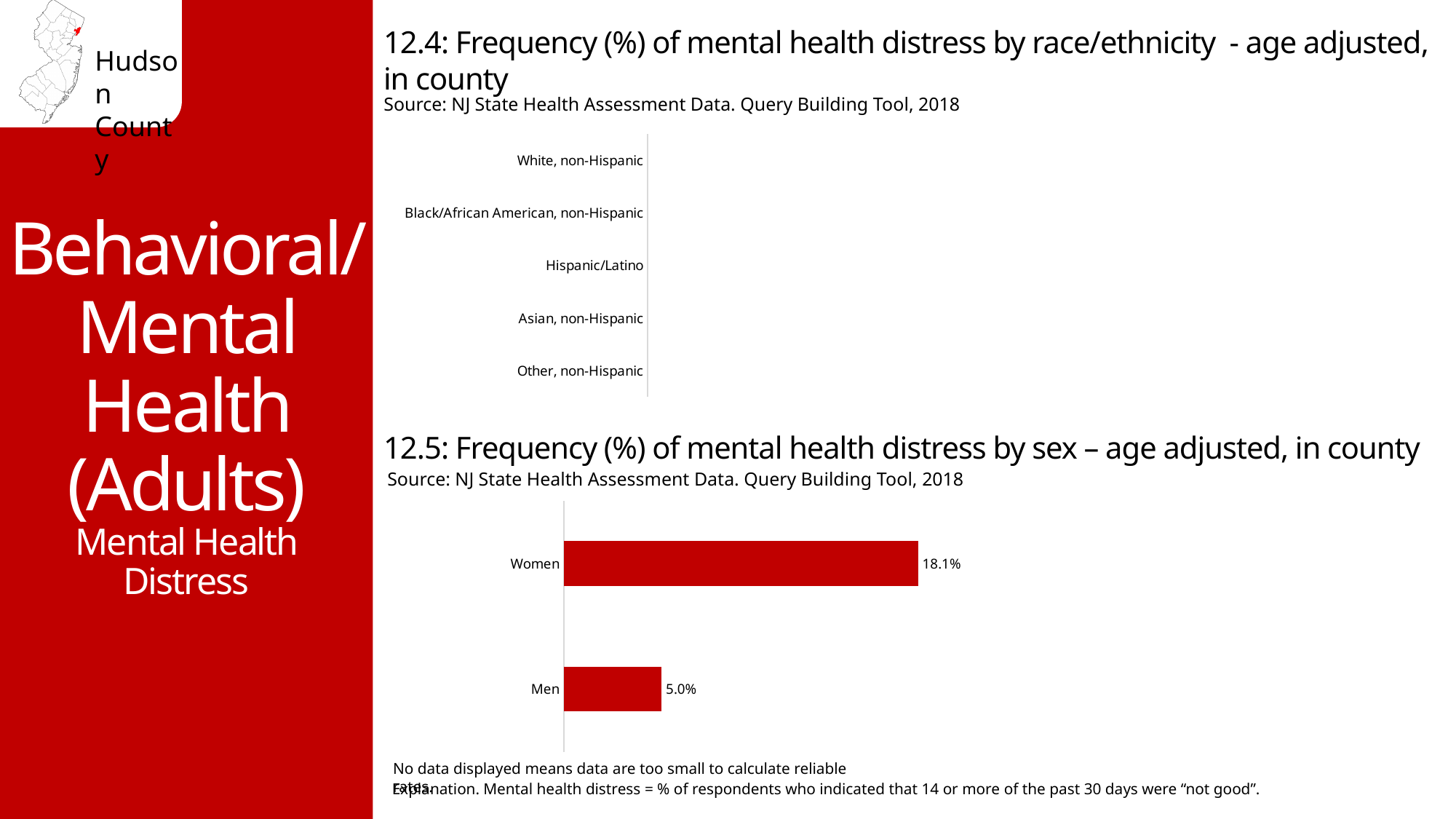
How many race/ethnicity categories are listed on the axis of the top chart (12.4)? 5 What kind of chart is the bottom chart (12.5)? bar chart In the chart '12.5: Frequency (%) of mental health distress by sex', what is the value for Men? 5.0% In the bottom chart (12.5), which category has the lowest value? Men What colour are the bars in the bottom chart (12.5)? red How many categories are plotted in the bottom chart (12.5)? 2 In the bottom chart (12.5), what is the difference between the values for Women and Men? 13.1% What is the title of the bottom chart on the slide? 12.5: Frequency (%) of mental health distress by sex – age adjusted, in county In the bottom chart (12.5), which category has the highest value? Women In the chart '12.5: Frequency (%) of mental health distress by sex', what is the value for Women? 18.1% In the bottom chart (12.5), is the value for Women larger or smaller than the value for Men? larger